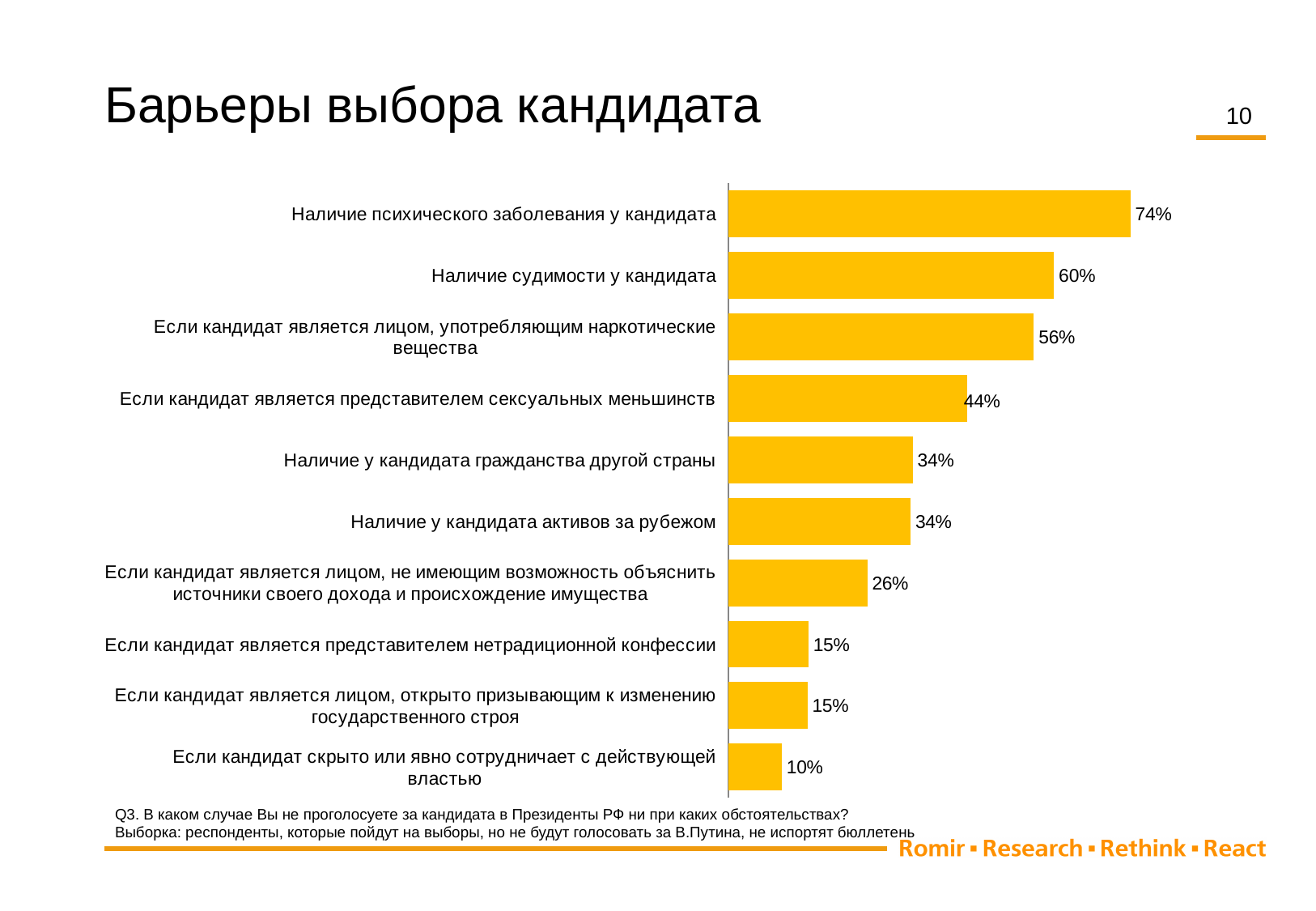
What is the value for "Если кандидат является представителем сексуальных меньшинств"? 44% What is the title of the slide? Барьеры выбора кандидата Which category has the lowest value? Если кандидат скрыто или явно сотрудничает с действующей властью What kind of chart is shown on the slide? Bar chart What is the value for "Наличие судимости у кандидата"? 60% Which is larger: the value for "Наличие у кандидата гражданства другой страны" or the value for "Если кандидат является представителем нетрадиционной конфессии"? Наличие у кандидата гражданства другой страны What is the value for "Если кандидат является лицом, не имеющим возможность объяснить источники своего дохода и происхождение имущества"? 26% What is the value for "Наличие психического заболевания у кандидата"? 74% How many categories are shown on the chart? 10 Which category has the highest value? Наличие психического заболевания у кандидата What is the difference between the highest and lowest values on the chart? 64% What is the difference between the values for "Наличие судимости у кандидата" and "Если кандидат является лицом, употребляющим наркотические вещества"? 4%